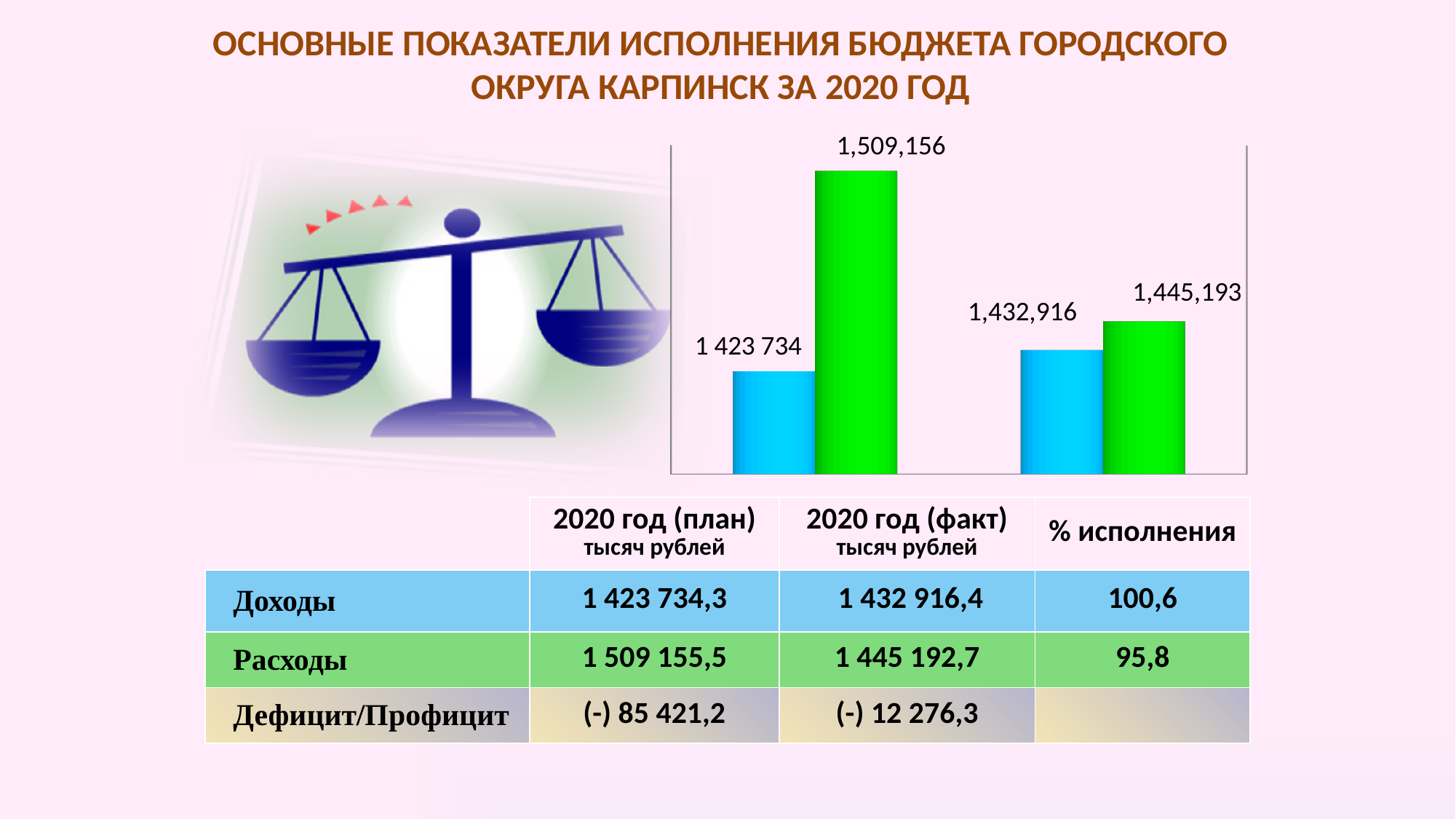
What two colours are used for the bars in the chart? blue and green What is the data label on the green bar in the left group of the chart? 1,509,156 Which green bar is taller, the one in the left group or the one in the right group? the one in the left group Which bar in the chart has the lowest value? the blue bar in the left group (1 423 734) What is the data label on the blue bar in the left group of the chart? 1 423 734 In the left group of the chart, how much larger is the green bar's value than the blue bar's value? 85,422 What type of chart is shown on the slide? bar chart What is the data label on the green bar in the right group of the chart? 1,445,193 What is the data label on the blue bar in the right group of the chart? 1,432,916 How many bars are plotted in the chart? 4 Which bar in the chart has the highest value? the green bar in the left group (1,509,156) In the left group of the chart, which bar is taller, the blue one or the green one? the green one